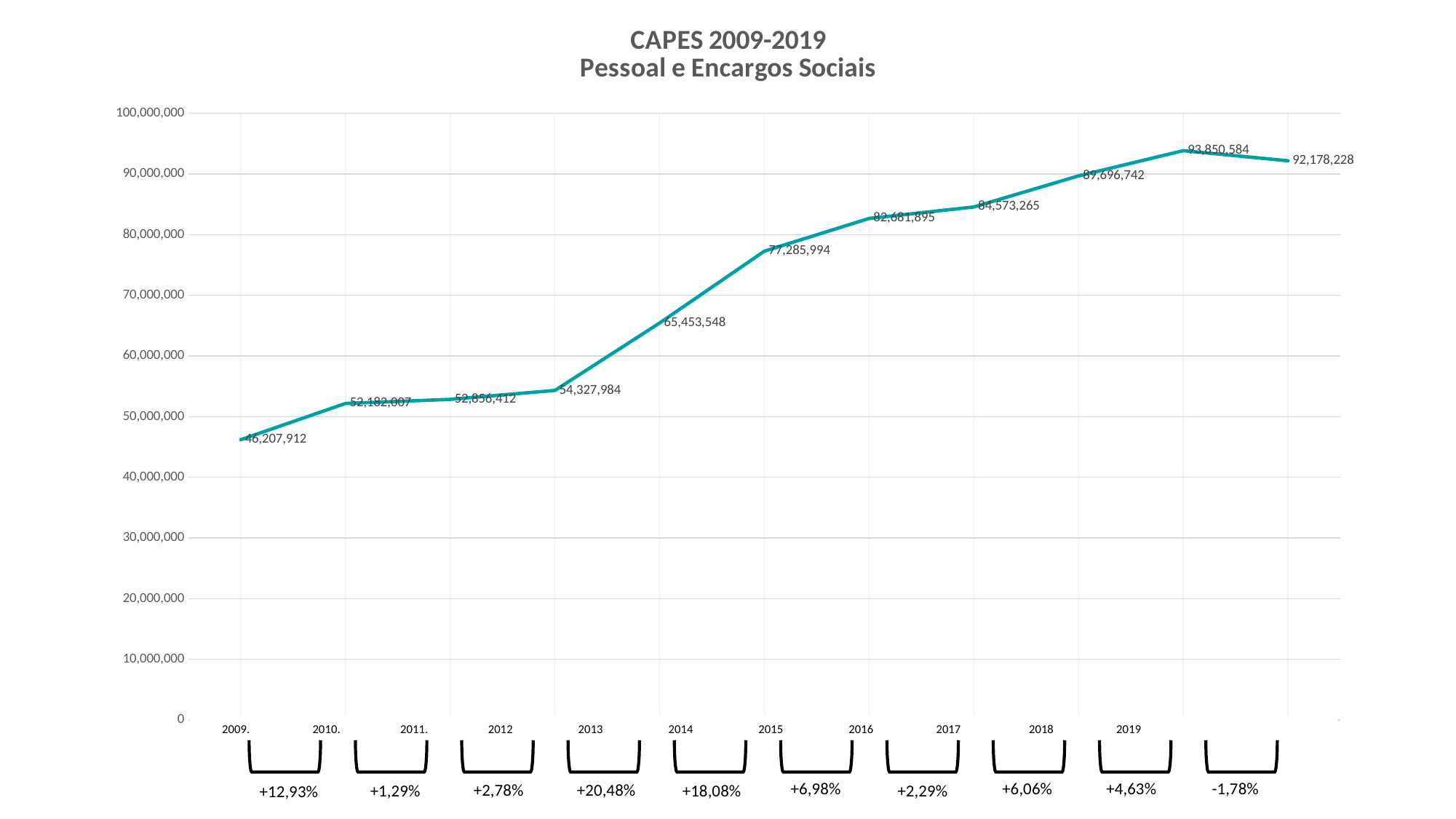
What is the difference between the values for 2013 and 2012? 11,125,564 What kind of chart is shown on the slide? line chart What is the value for 2014? 77,285,994 Which is larger, the value for 2015 or the value for 2016? 2016 What is the difference between the values for 2018 and 2019? 1,672,356 Which year has the lowest value? 2009 What is the overall trend of the values from 2009 to 2018? rising Which year has the highest value? 2018 How many data points are plotted on the line? 11 What is the title of the chart? CAPES 2009-2019 Pessoal e Encargos Sociais What is the value for 2009? 46,207,912 What is the value for 2019? 92,178,228